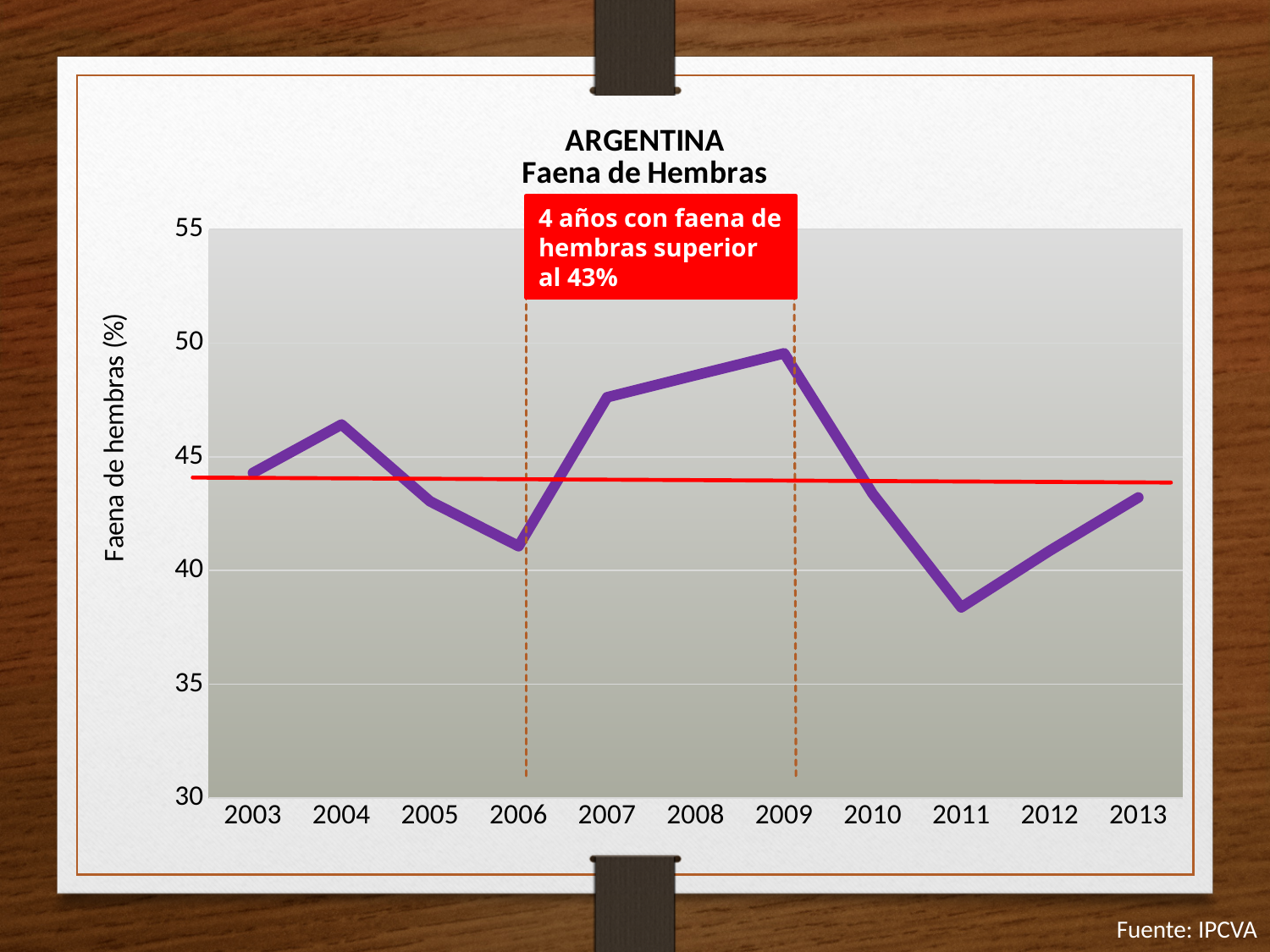
Is the value for 2006 greater or less than 40? greater Which year has the highest value for Faena de hembras? 2009 What is the title of the chart? ARGENTINA Faena de Hembras Is the value for 2009 greater or less than 45? greater Is the value for 2011 greater or less than 40? less Which year has the larger value, 2004 or 2006? 2004 Which year has the lowest value for Faena de hembras? 2011 Do the values rise or fall from 2006 to 2009? rise How many years are plotted along the x axis? 11 What kind of chart is shown on the slide? Line chart What is the label of the y axis? Faena de hembras (%)